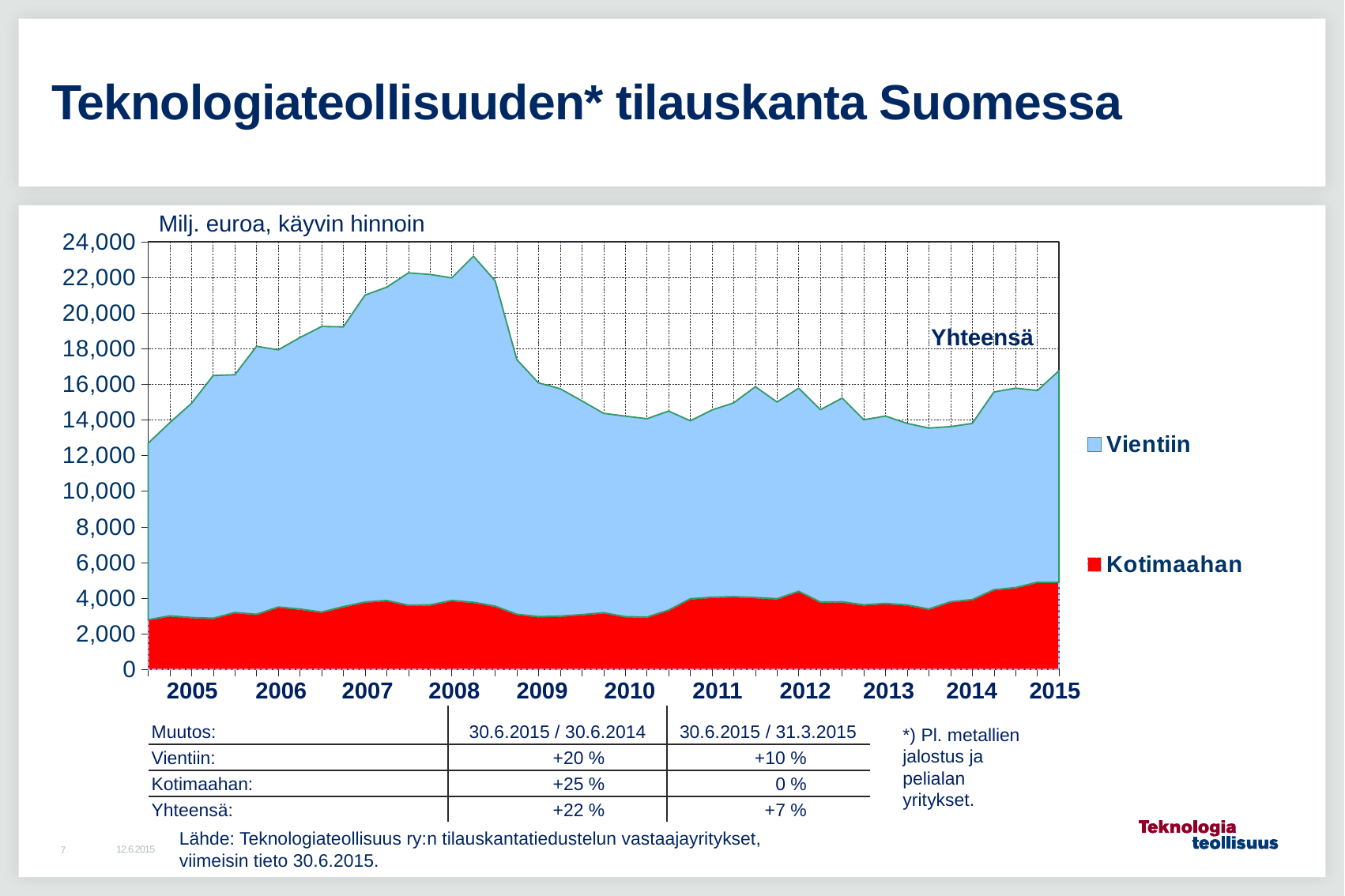
Is the total (Yhteensä) value at the start of 2005 greater or less than 14,000? less How many series does the legend list? 2 Is the Kotimaahan value at the end of the series in 2015 greater or less than 4,000? greater What unit label is shown above the chart? Milj. euroa, käyvin hinnoin Is the total (Yhteensä) value at the end of the series in 2015 greater or less than 18,000? less What kind of chart is shown on the slide? area chart Does the total (Yhteensä) rise or fall between the 2008 peak and 2009? fall Does the total (Yhteensä) rise or fall between 2005 and the peak in 2008? rise How many year labels are shown on the x axis? 11 What are the two series named in the legend? Vientiin and Kotimaahan